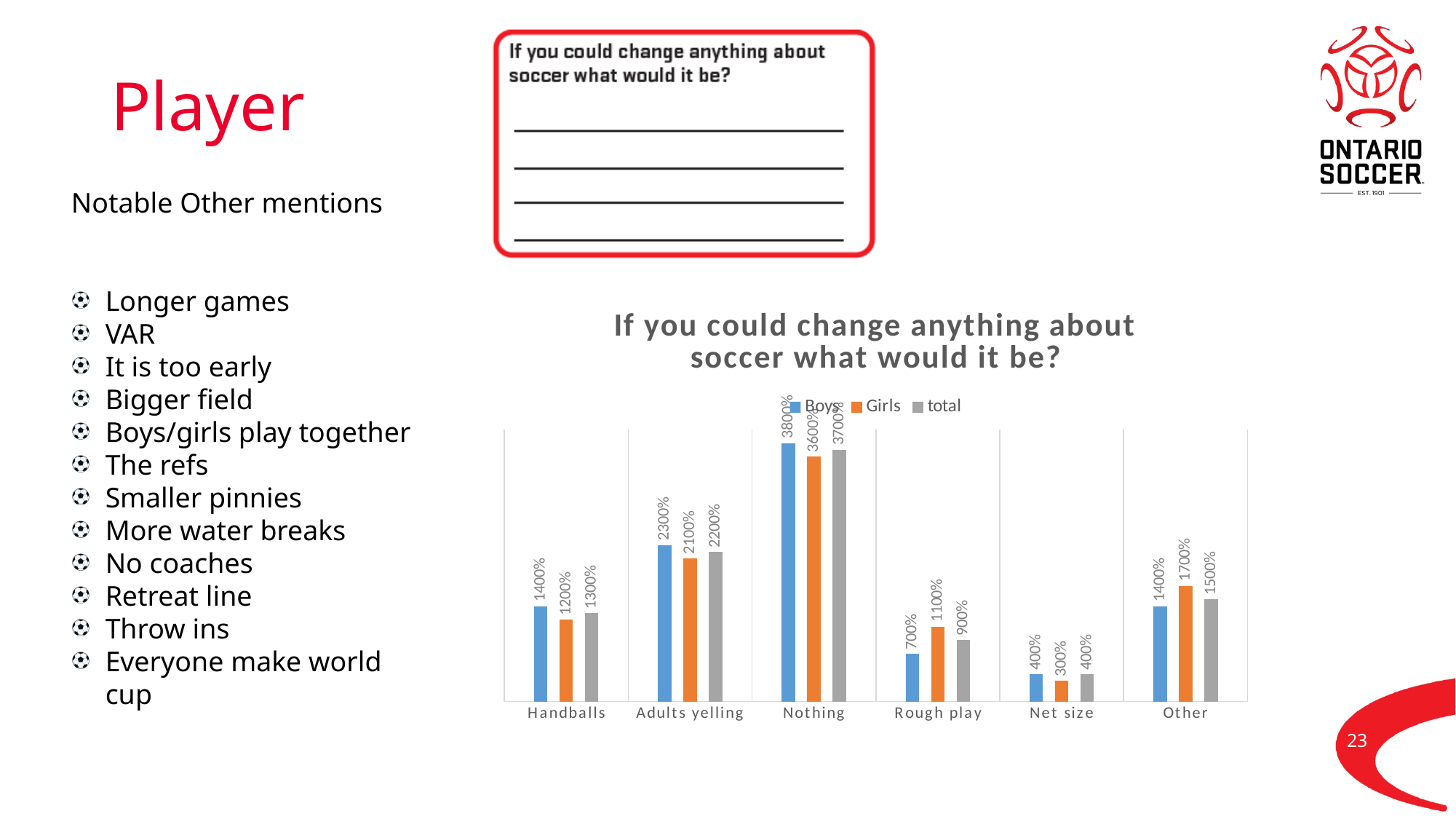
How many series does the legend list? 3 What is the total value for Other? 1500% What is the Boys value for Nothing? 3800% Which is larger for Rough play, the Boys value or the Girls value? Girls What is the title of the chart? If you could change anything about soccer what would it be? What is the Girls value for Net size? 300% How many categories are shown on the x axis? 6 What is the Girls value for Adults yelling? 2100% Which category has the highest Boys value? Nothing What is the difference between the Boys and Girls values for Handballs? 200% What kind of chart is shown? Bar chart Which category has the lowest total value? Net size